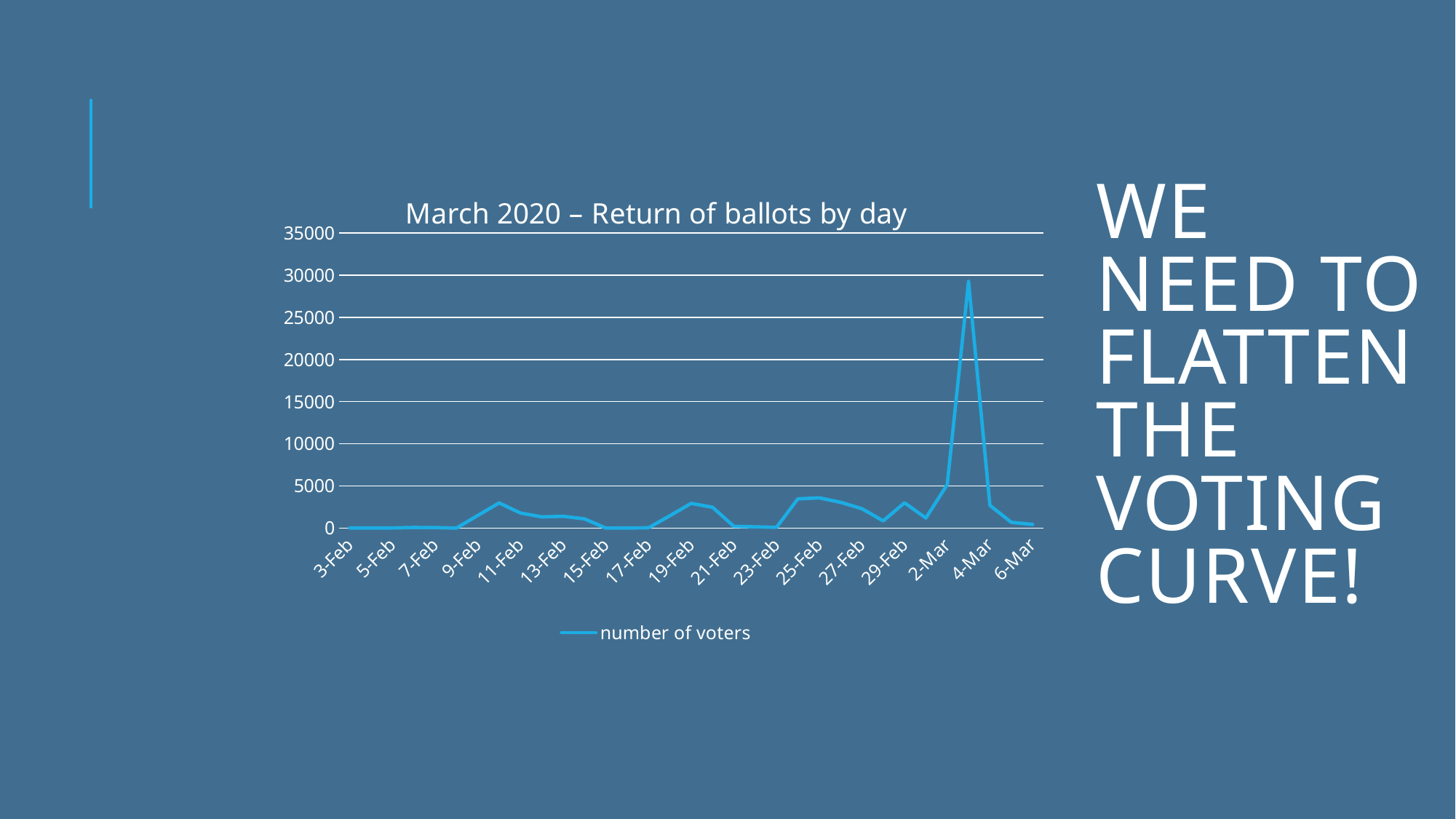
What kind of chart is shown on the slide? line chart What is the title of the chart? March 2020 – Return of ballots by day How many series does the legend list? 1 What is the highest value shown on the y axis? 35000 Is the value for 6-Mar greater or less than 5000? less What is the name of the series shown in the legend? number of voters Is the value for 25-Feb greater or less than 10000? less Is the value for 11-Feb greater or less than 5000? less Does the line rise or fall between 4-Mar and 6-Mar? fall Does the line rise or fall between 23-Feb and 25-Feb? rise